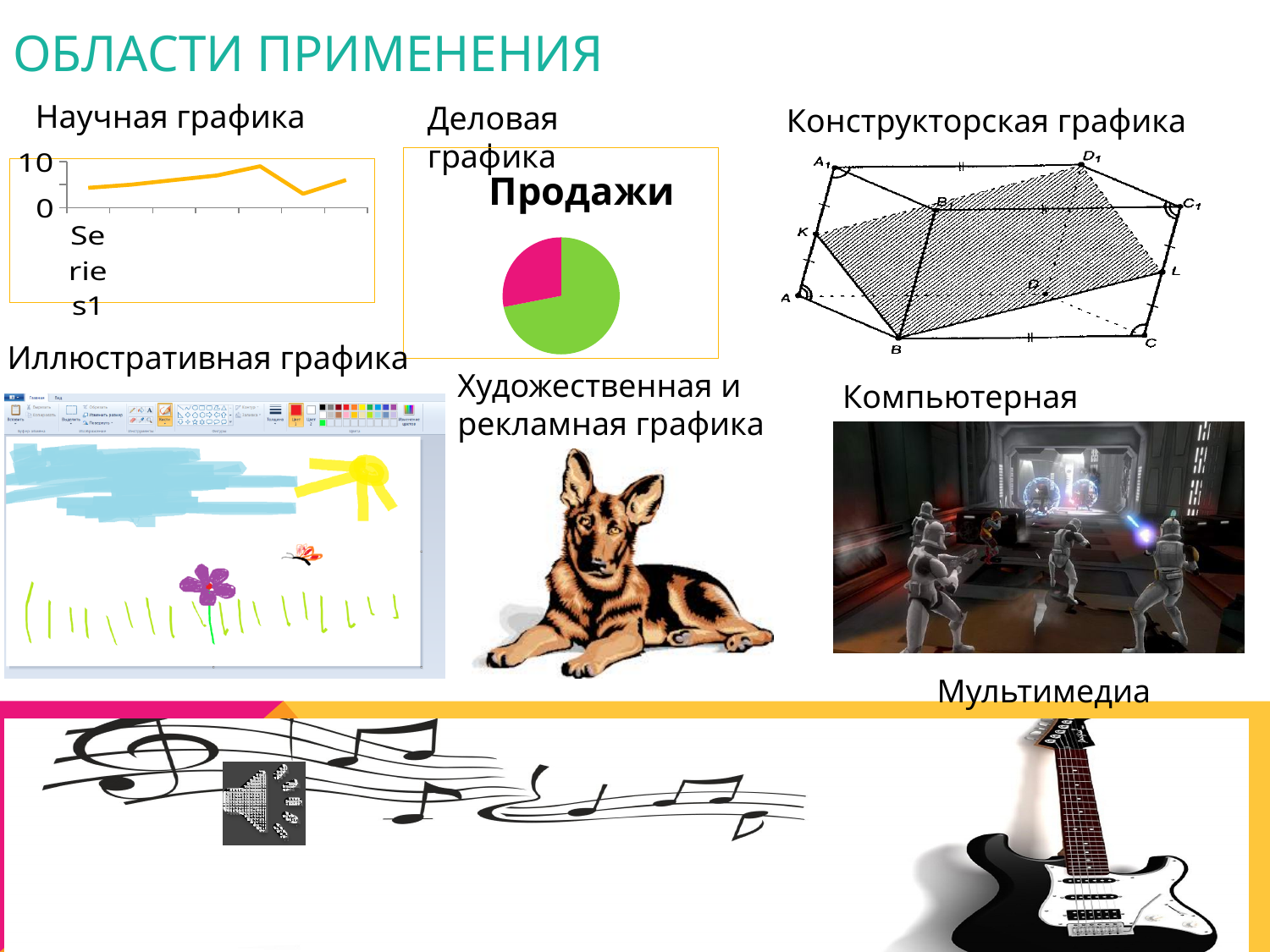
In the "Продажи" pie chart, is the pink slice larger or smaller than the green slice? smaller How many slices does the "Продажи" pie chart have? 2 What kind of chart is the "Продажи" chart? pie chart How many series does the legend of the line chart under "Научная графика" list? 1 What is the title of the pie chart? Продажи What is the legend entry of the line chart under "Научная графика"? Series1 In the line chart under "Научная графика", is the highest point of the line greater or less than 10? less What kind of chart is shown under the heading "Научная графика"? line chart In the "Продажи" pie chart, which slice is the largest? the green slice In the line chart under "Научная графика", does the line rise or fall immediately after its highest point? fall